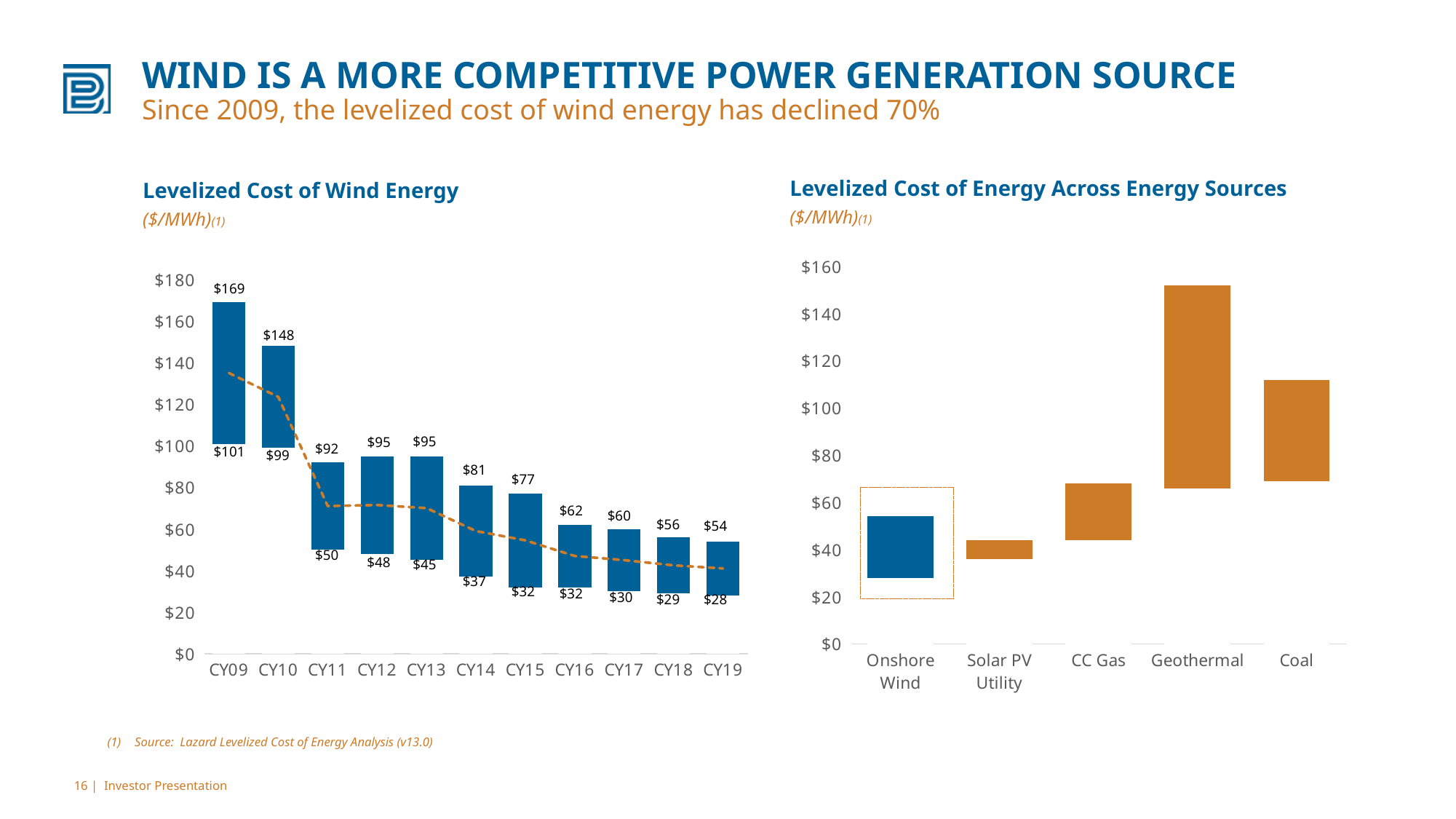
In the Levelized Cost of Wind Energy chart, which year has the lowest lower value? CY19 In the Levelized Cost of Wind Energy chart, what is the difference between the upper value for CY09 and the upper value for CY19? $115 How many years are shown on the x axis of the Levelized Cost of Wind Energy chart? 11 In the Levelized Cost of Energy Across Energy Sources chart, is the top of the Geothermal bar greater or less than $140? greater In the Levelized Cost of Wind Energy chart, what is the upper value shown for CY09? $169 In the Levelized Cost of Wind Energy chart, what is the lower value shown for CY19? $28 In the Levelized Cost of Wind Energy chart, which year has the highest upper value? CY09 In the Levelized Cost of Wind Energy chart, do the upper values rise or fall from CY09 to CY19? Fall In the Levelized Cost of Wind Energy chart, which is larger: the upper value for CY12 or the upper value for CY14? CY12 In the Levelized Cost of Energy Across Energy Sources chart, which energy source has the highest upper value? Geothermal How many energy sources are shown in the Levelized Cost of Energy Across Energy Sources chart? 5 In the Levelized Cost of Wind Energy chart, what is the upper value shown for CY14? $81